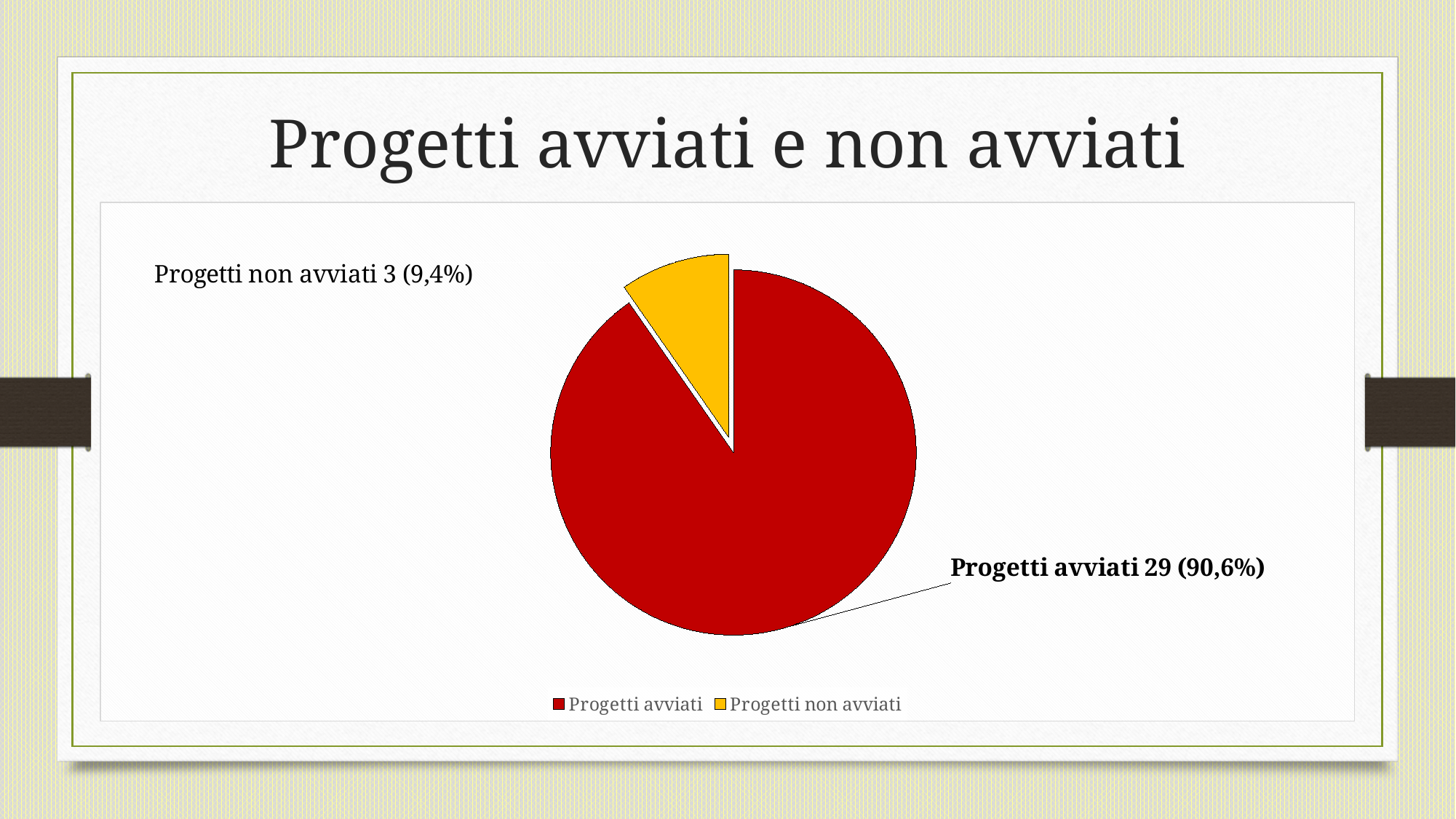
What colour is the 'Progetti non avviati' slice? yellow Which is larger, 'Progetti avviati' or 'Progetti non avviati'? Progetti avviati What kind of chart is shown on the slide? pie chart How many projects are shown as 'Progetti avviati'? 29 What share of the pie does 'Progetti avviati' represent? 90,6% How many projects are shown as 'Progetti non avviati'? 3 Which category has the smallest slice of the pie? Progetti non avviati Which category has the largest slice of the pie? Progetti avviati What share of the pie does 'Progetti non avviati' represent? 9,4% How many categories does the pie chart have? 2 What is the difference between the number of 'Progetti avviati' and 'Progetti non avviati'? 26 What is the total number of projects represented in the pie chart? 32